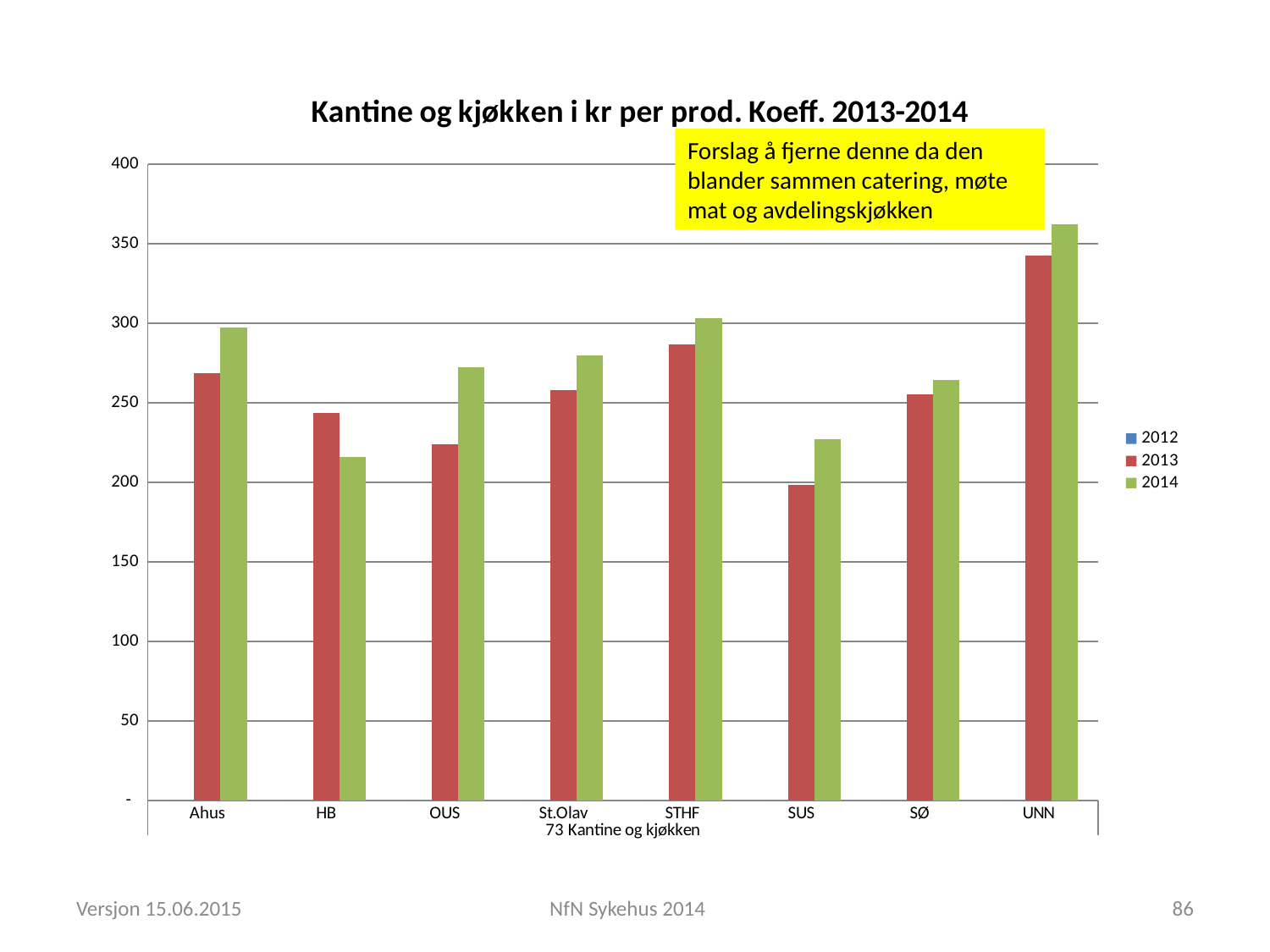
Which hospital has the lowest value for 2013? SUS Is the 2014 value for UNN greater or less than 350? greater What kind of chart is shown on the slide? bar chart What is the title of the chart? Kantine og kjøkken i kr per prod. Koeff. 2013-2014 For HB, which year has the larger value, 2013 or 2014? 2013 How many series does the legend list? 3 Is the 2014 value for HB greater or less than 200? greater How many hospitals (categories) are shown on the x axis? 8 Which hospital has the highest value for 2014? UNN Is the 2013 value for OUS greater or less than 250? less Which hospital has the lowest value for 2014? HB Which hospital has the highest value for 2013? UNN